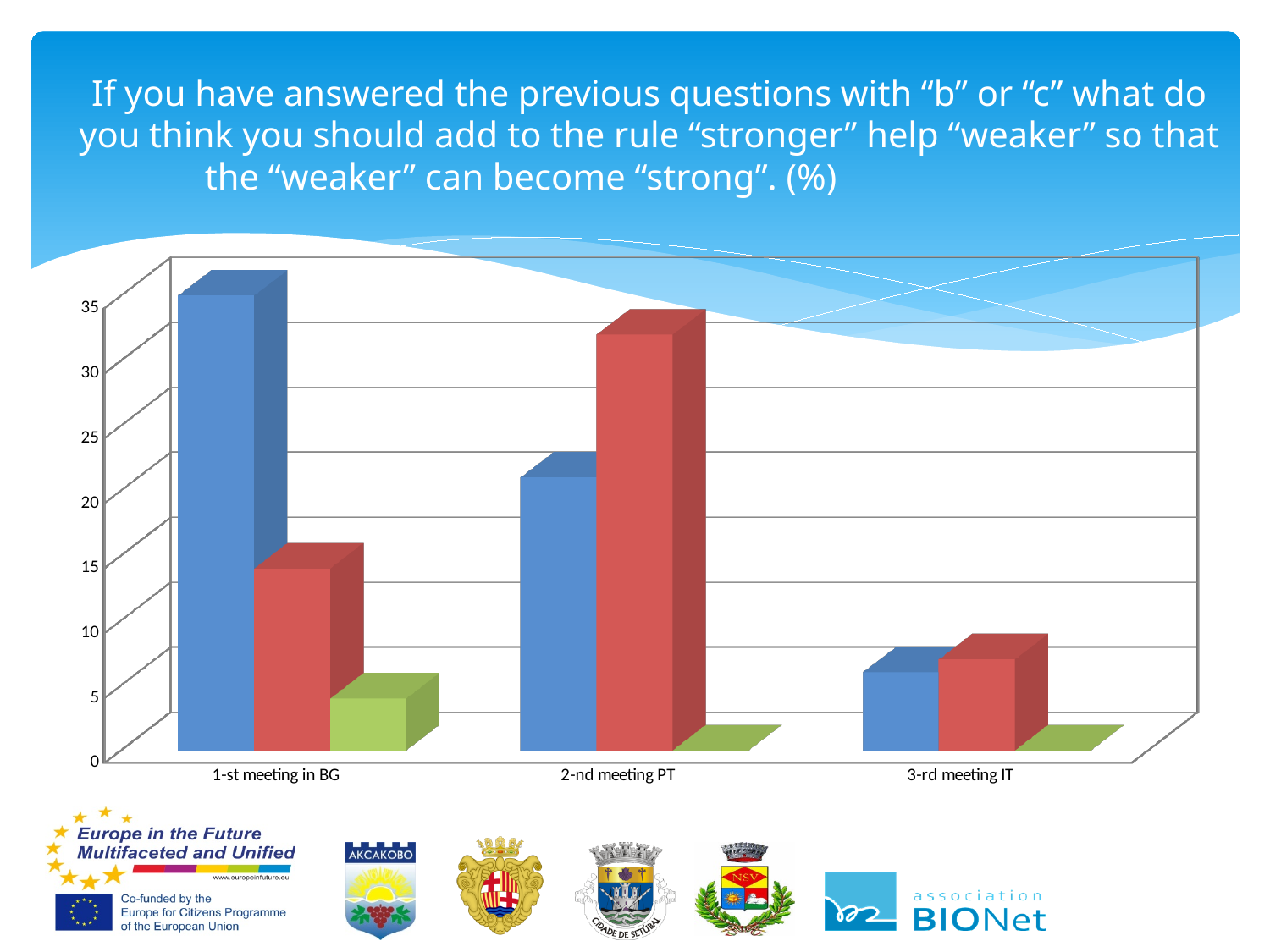
Do the blue bars rise or fall from 1-st meeting in BG to 3-rd meeting IT? fall Is the value of the blue bar for 3-rd meeting IT greater or less than 10? less How many categories are shown on the x axis of the chart? 3 Is the value of the red bar for 1-st meeting in BG greater or less than 20? less Is the value of the blue bar for 1-st meeting in BG greater or less than 30? greater Which category has the shortest blue bar? 3-rd meeting IT For 2-nd meeting PT, which is larger, the blue bar or the red bar? the red bar What kind of chart is shown on the slide? bar chart For 1-st meeting in BG, which is larger, the blue bar or the red bar? the blue bar Which category has the tallest blue bar? 1-st meeting in BG